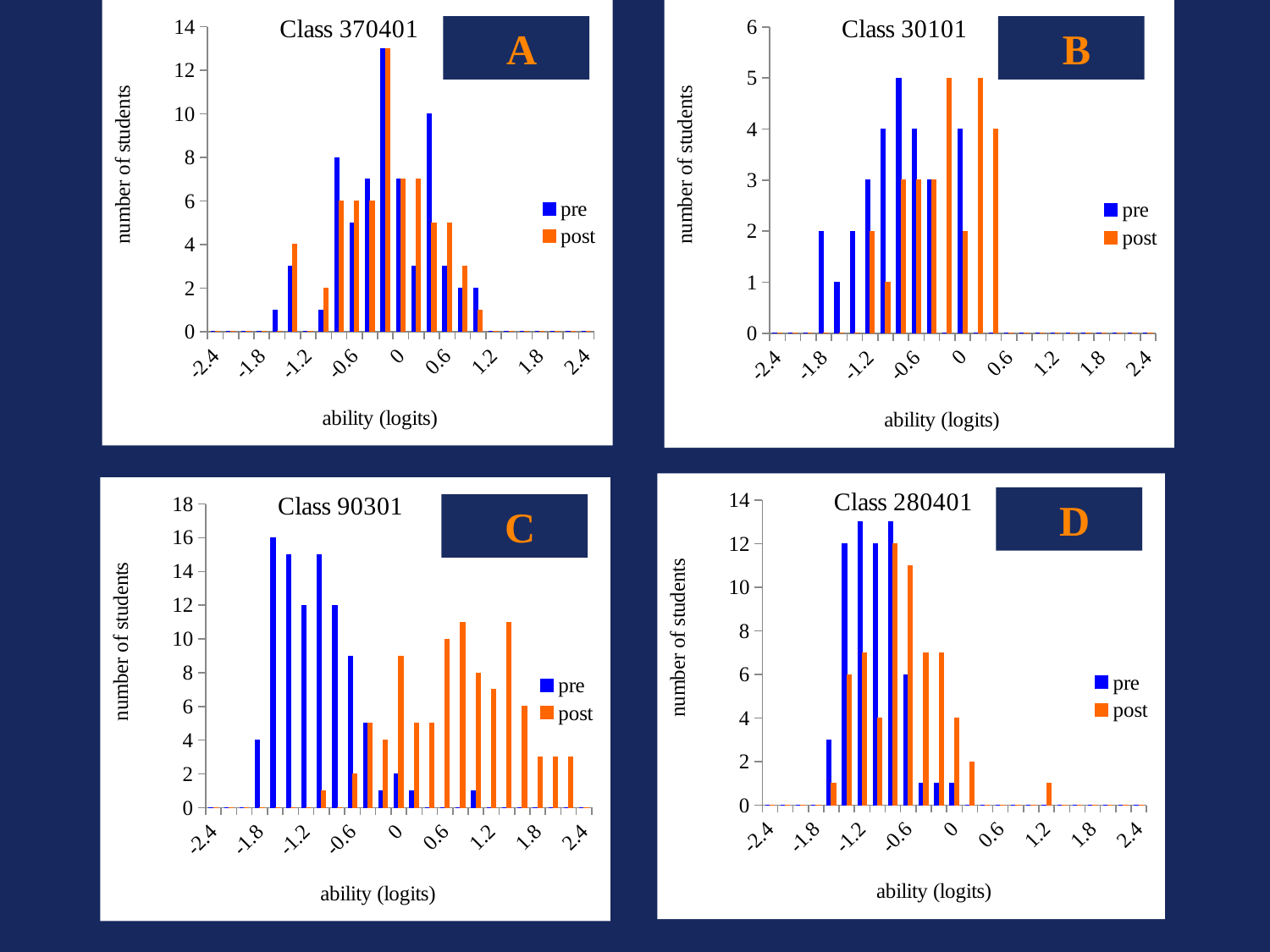
What are the two legend entries in the Class 90301 chart (C)? pre and post In the Class 370401 chart (A), is the tallest post bar greater or less than 8? greater In the Class 30101 chart (B), what is the value of the tallest pre bar? 5 In the Class 280401 chart (D), what is the value of the tallest post bar? 12 In the Class 370401 chart (A), is the tallest pre bar greater or less than 12? greater In the Class 90301 chart (C), which series has the tallest bar, pre or post? pre In the Class 90301 chart (C), is the tallest post bar greater or less than 10? greater How many series does the legend of the Class 30101 chart (B) list? 2 What kind of chart is the Class 370401 chart (A)? bar chart In the Class 90301 chart (C), what is the value of the tallest pre bar? 16 What is the x-axis label of the Class 30101 chart (B)? ability (logits)